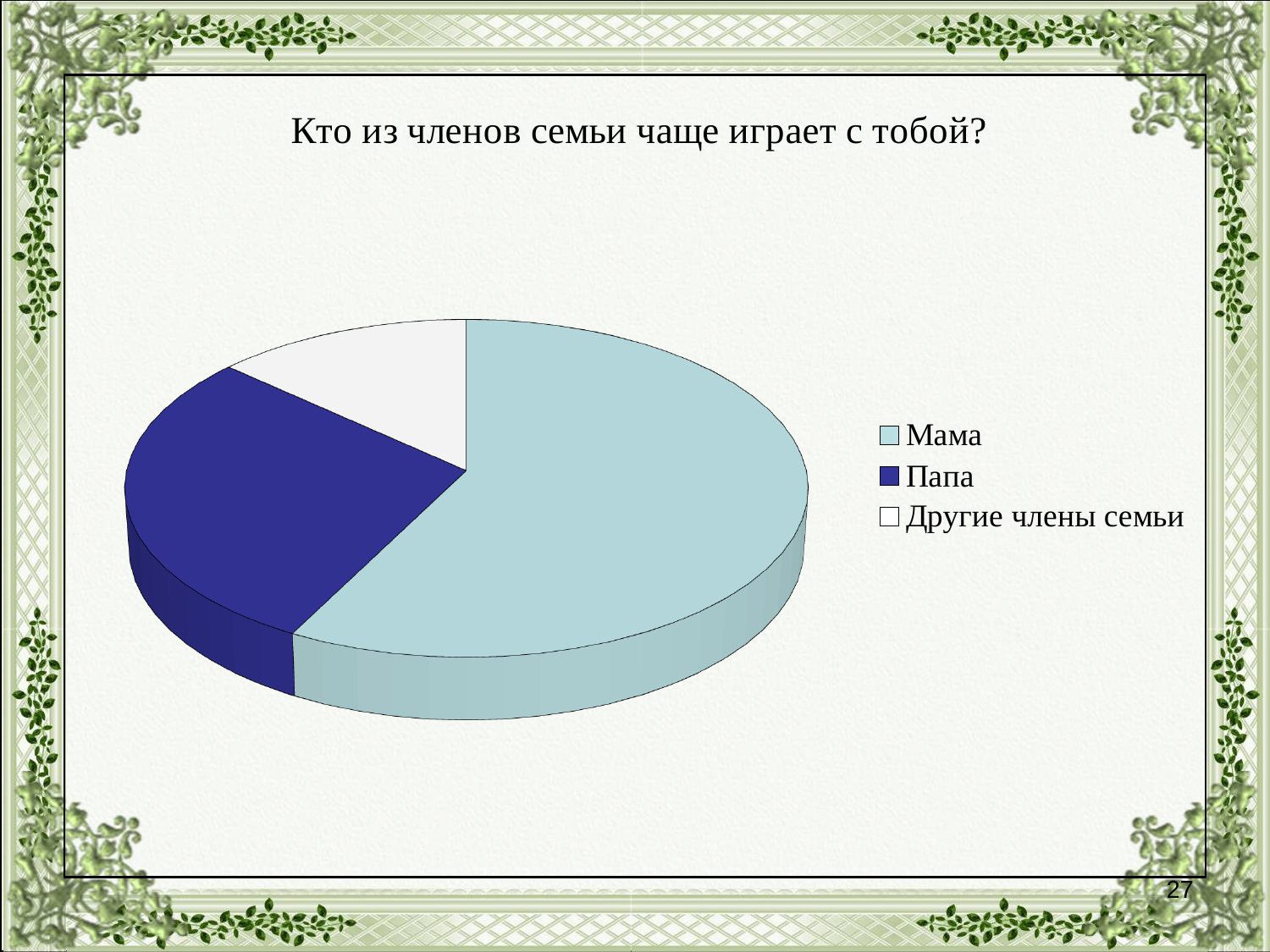
Does the Мама slice take up more or less than half of the pie? More How many entries does the legend list? 3 Which category has the smallest slice of the pie? Другие члены семьи How many categories does the pie chart have? 3 What is the title of the chart? Кто из членов семьи чаще играет с тобой? Which slice is smaller, Мама or Другие члены семьи? Другие члены семьи Which category has the largest slice of the pie? Мама Which category is shown in dark blue? Папа What kind of chart is shown on the slide? Pie chart Which slice is larger, Папа or Другие члены семьи? Папа